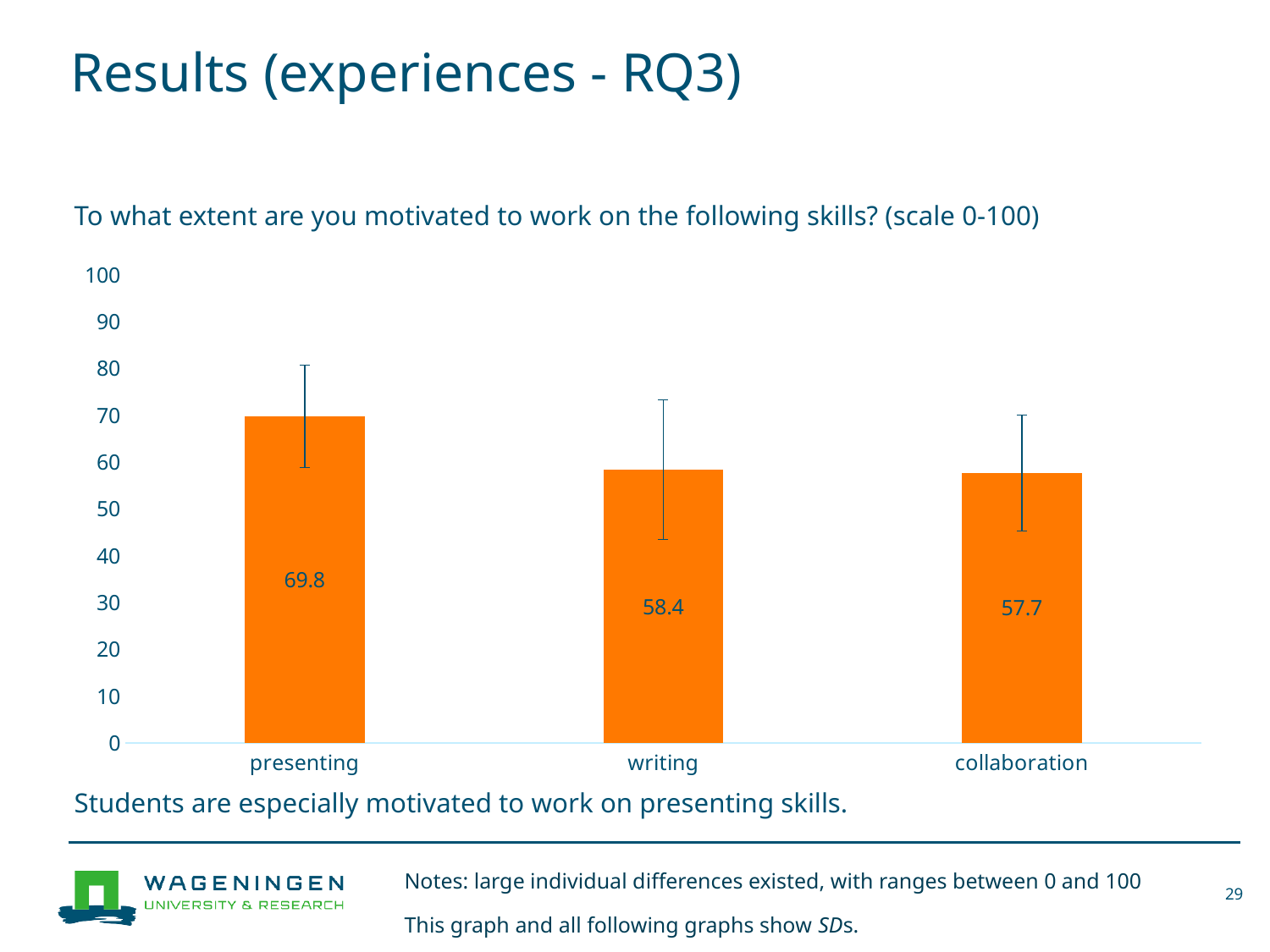
What is the value for writing? 58.4 Which skill has the lowest motivation value? collaboration What is the value for presenting? 69.8 What is the difference between the values for presenting and writing? 11.4 Which skill has the highest motivation value? presenting What is the value for collaboration? 57.7 What is the difference between the values for presenting and collaboration? 12.1 Is the value for writing greater or less than 60? less What kind of chart is shown on the slide? bar chart How many skills are shown on the chart? 3 Which is larger, the value for presenting or the value for collaboration? presenting Do the values rise or fall from presenting to collaboration along the x axis? fall